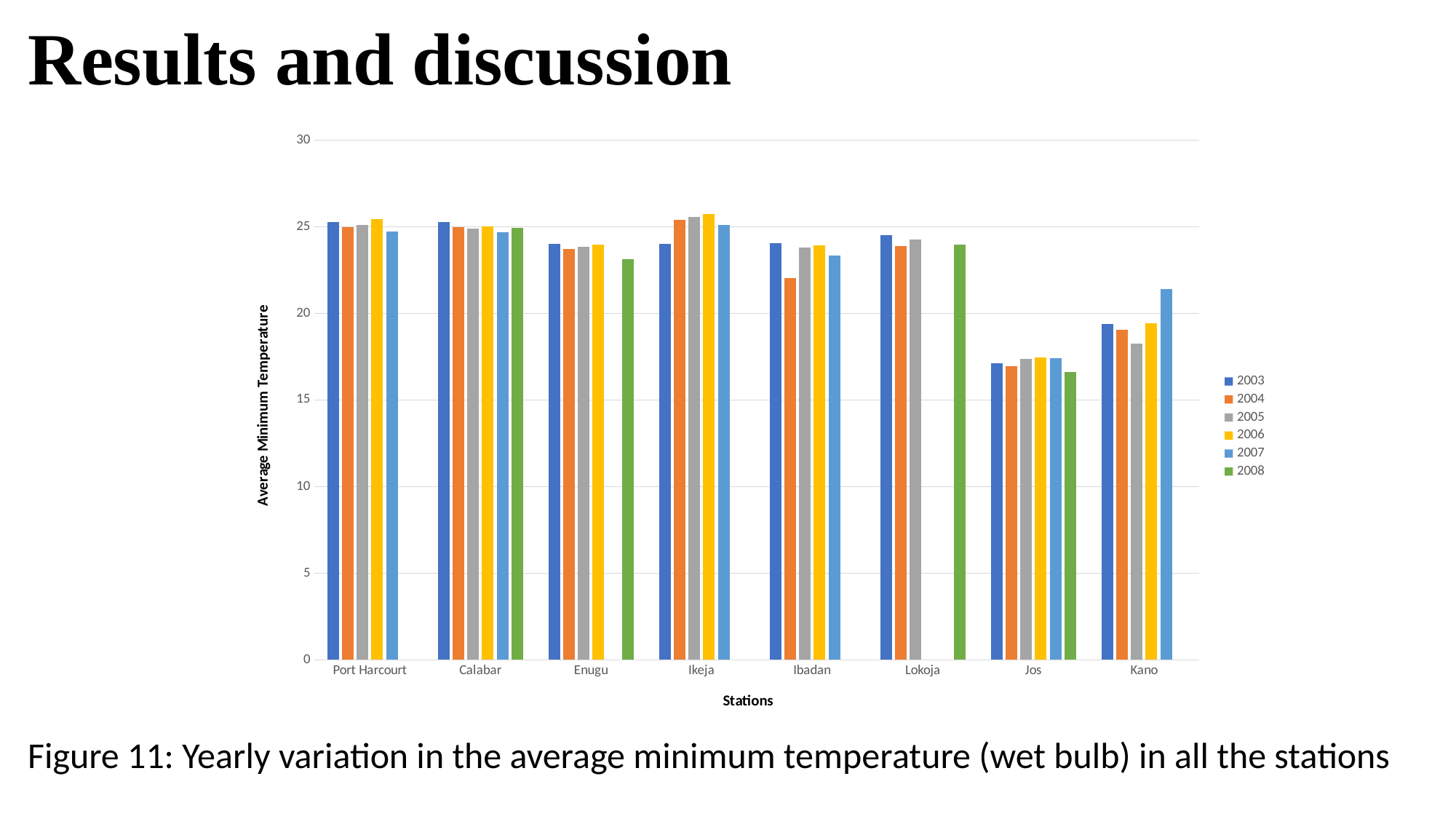
How many bars are plotted for Lokoja? 4 Is the value for Kano in 2007 greater or less than 20? greater Which is larger, the 2003 value for Jos or the 2003 value for Kano? Kano What kind of chart is shown on the slide? bar chart For Kano, which year has the highest bar? 2007 How many stations are shown on the x axis? 8 What is the label on the y axis? Average Minimum Temperature Which station has the lowest average minimum temperature across all years? Jos Is the value for Jos in 2003 greater or less than 20? less For Ibadan, which year has the lowest bar? 2004 How many series does the legend list? 6 Is the value for Enugu in 2008 greater or less than 25? less